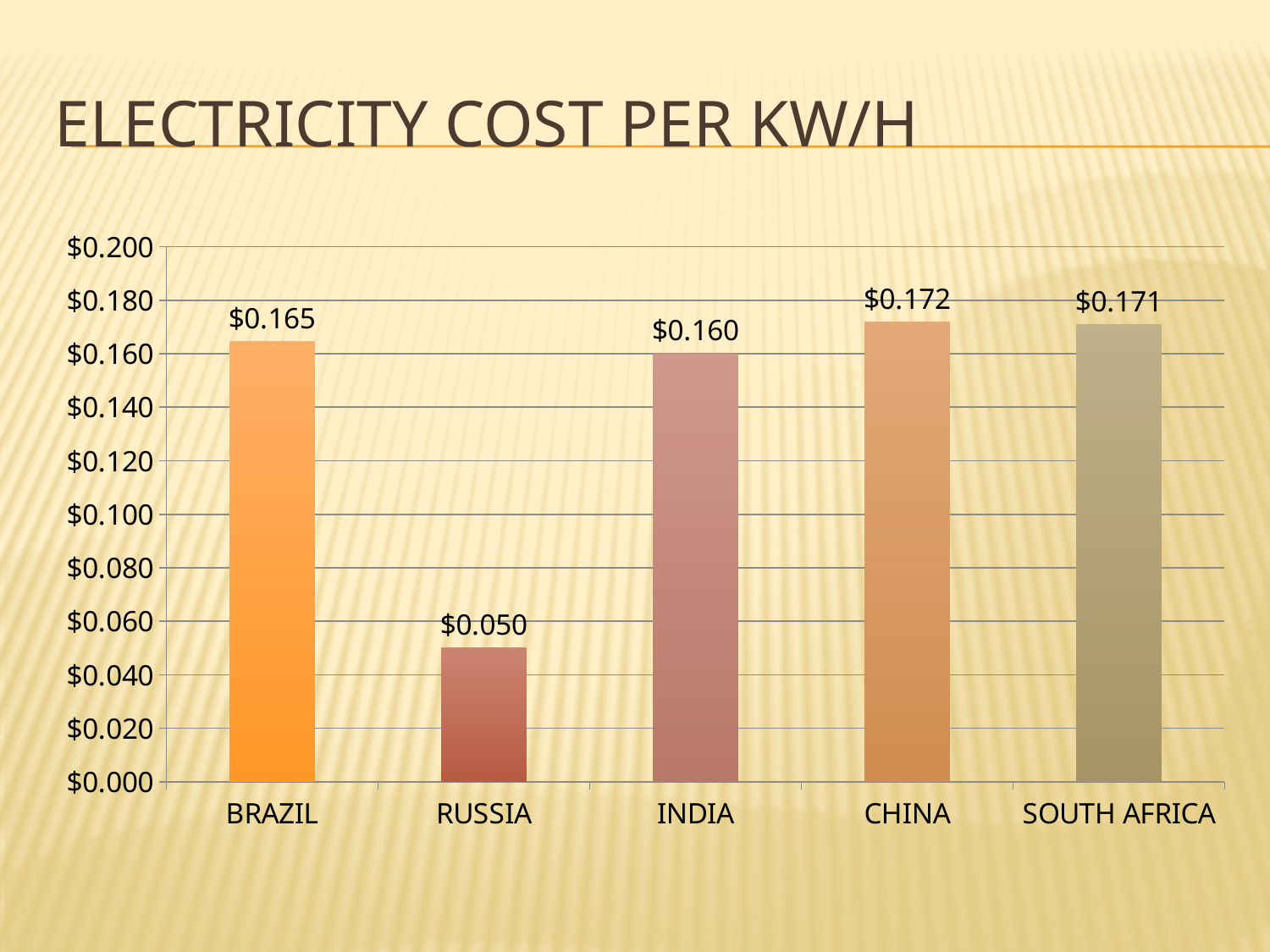
What kind of chart is shown on the slide? Bar chart How many countries are shown in the chart? 5 Is the value for Russia greater or less than $0.060? less Which country has the highest electricity cost per kW/h? China What is the difference between the electricity cost for Brazil and India? $0.005 What is the electricity cost per kW/h for South Africa? $0.171 What is the electricity cost per kW/h for Brazil? $0.165 What is the electricity cost per kW/h for India? $0.160 Which has a higher electricity cost per kW/h, Brazil or India? Brazil What is the difference between the electricity cost for China and Russia? $0.122 Which country has the lowest electricity cost per kW/h? Russia What is the electricity cost per kW/h for Russia? $0.050